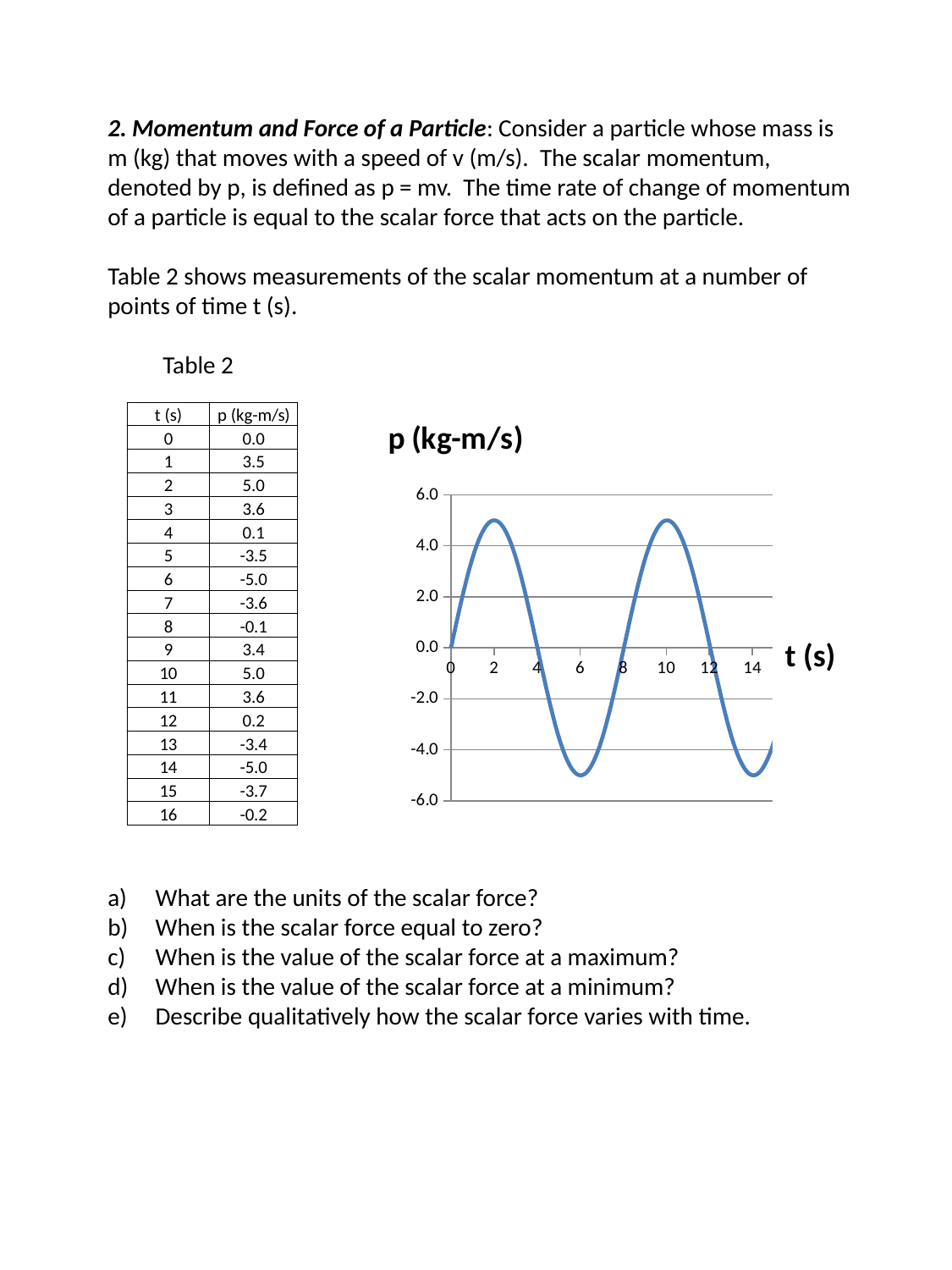
According to Table 2, what is the momentum p at t = 2 s? 5.0 What is the label on the x axis of the chart? t (s) What is the minimum value of p reached in the chart? -5.0 What kind of chart is shown on the slide? line chart What is the difference between p at t = 2 s and p at t = 6 s, using the values in Table 2? 10.0 Is the value of p at t = 13 s greater or less than -2.0? less What is the maximum value of p reached in the chart? 5.0 According to Table 2, what is the momentum p at t = 6 s? -5.0 What is the title of the chart? p (kg-m/s) Is the value of p at t = 1 s greater or less than 2.0? greater How many time points are listed in Table 2? 17 Between t = 2 s and t = 6 s, does the plotted value of p rise or fall? fall